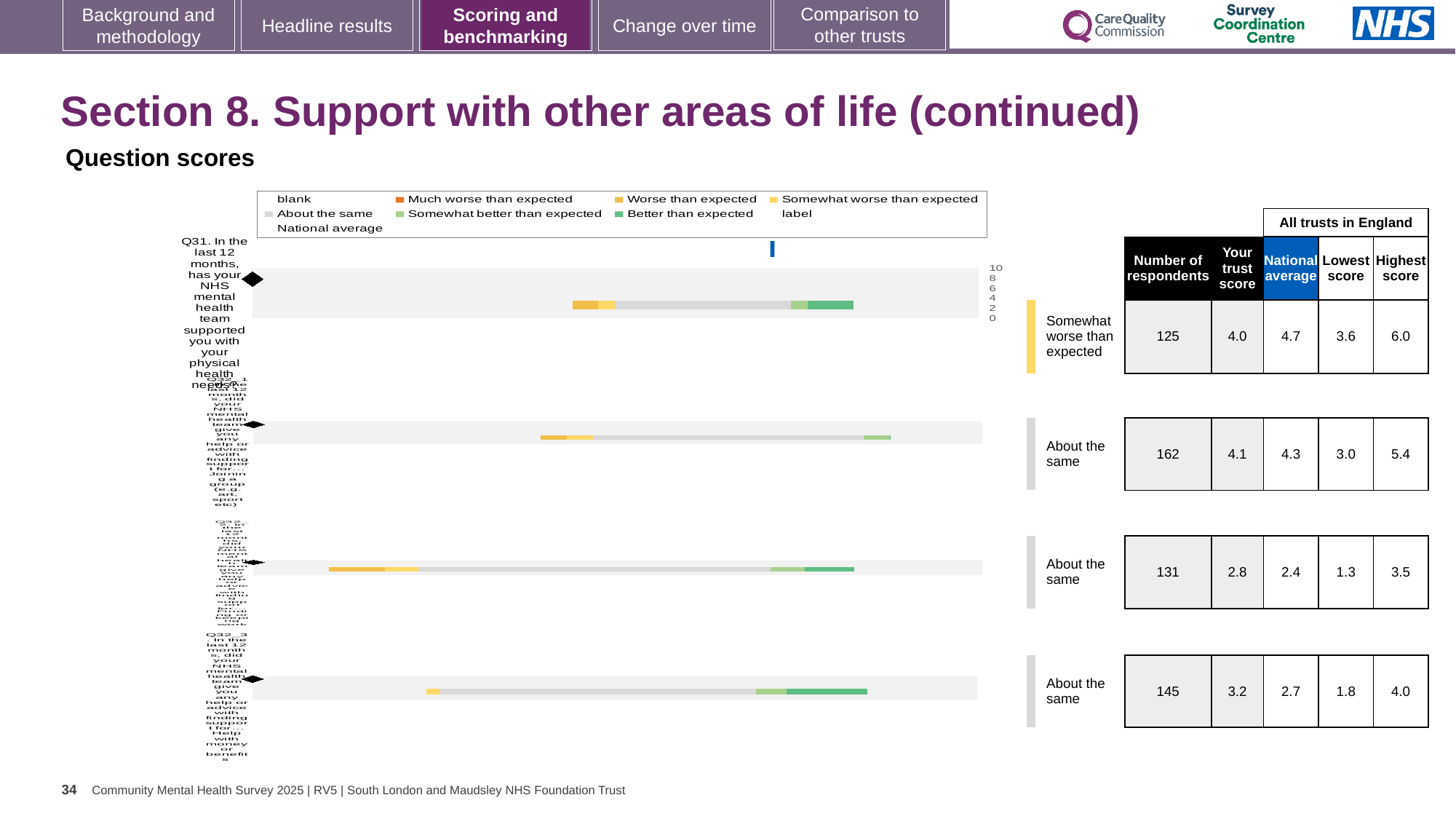
In the table beside the chart, what is the number of respondents for the first row (Q31)? 125 For the first row (Q31), what is the difference between the highest score and the lowest score? 2.4 For the first row (Q31), which is larger: the trust score or the national average? national average How many bars (question rows) are plotted in the chart? 4 Which question number is the first (top) bar of the chart labelled with? Q31 What benchmark label is shown next to the first bar (Q31)? Somewhat worse than expected How many entries does the chart legend list? 9 In the table beside the chart, what is 'Your trust score' for the first row (Q31)? 4.0 Which row in the table has the highest number of respondents? the second row (162) In the table beside the chart, what is the national average for the last (bottom) row? 2.7 What colour does the legend use for 'Better than expected'? green What kind of chart is shown on the slide? bar chart